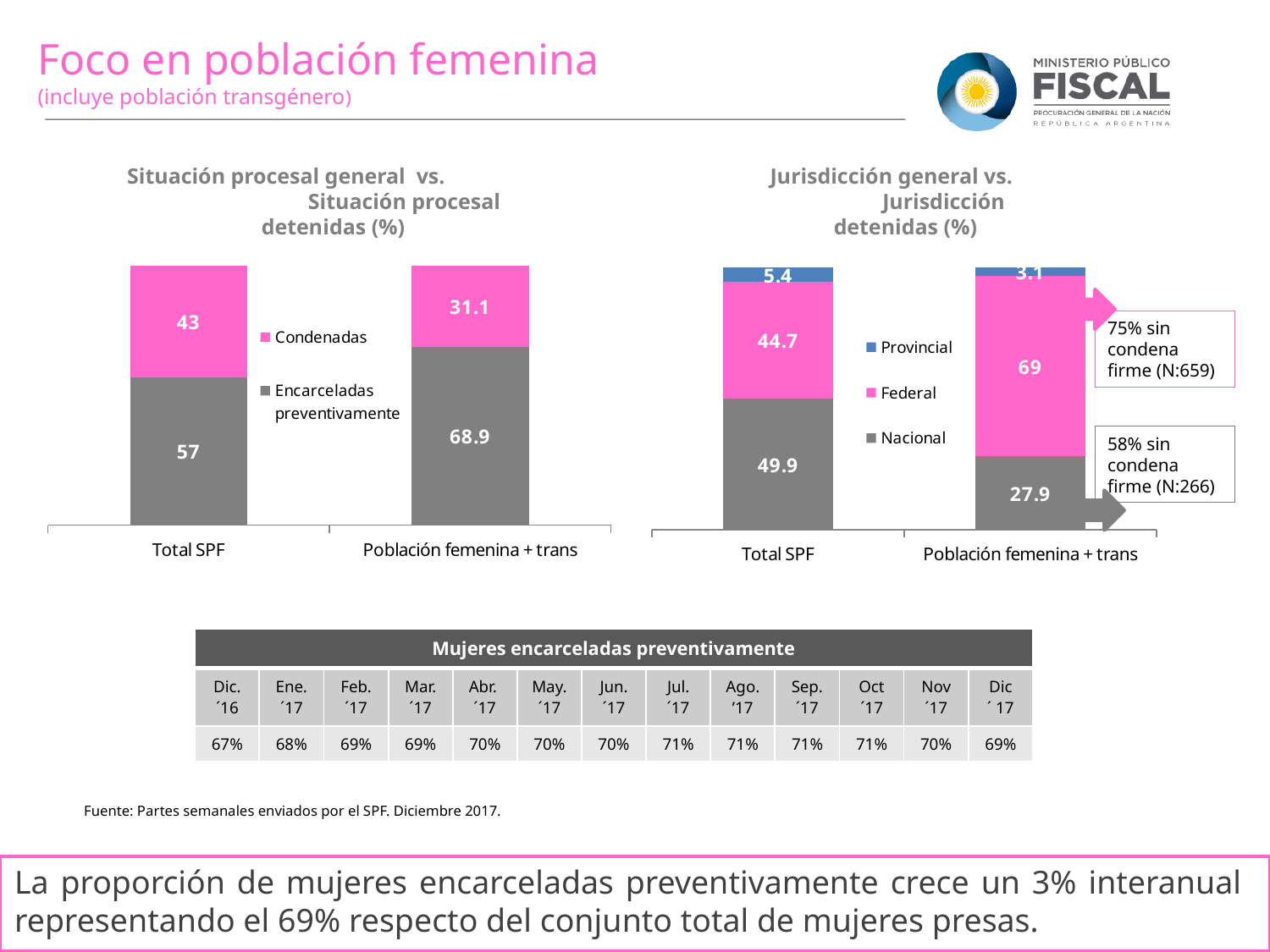
In the left chart (Situación procesal general vs. Situación procesal detenidas), what is the value for Encarceladas preventivamente for Total SPF? 57 In the left chart (Situación procesal general vs. Situación procesal detenidas), what is the value for Condenadas for Población femenina + trans? 31.1 In the right chart (Jurisdicción general vs. Jurisdicción detenidas), what is the difference between the Nacional values for Total SPF and Población femenina + trans? 22 In the right chart (Jurisdicción general vs. Jurisdicción detenidas), what is the value for Federal for Población femenina + trans? 69 In the left chart (Situación procesal general vs. Situación procesal detenidas), what is the difference between the Encarceladas preventivamente values for Población femenina + trans and Total SPF? 11.9 In the right chart (Jurisdicción general vs. Jurisdicción detenidas), how many series does the legend list? 3 What kind of chart is the right chart (Jurisdicción general vs. Jurisdicción detenidas)? Stacked bar chart In the left chart (Situación procesal general vs. Situación procesal detenidas), which category has the higher Condenadas value, Total SPF or Población femenina + trans? Total SPF In the right chart (Jurisdicción general vs. Jurisdicción detenidas), what is the value for Provincial for Total SPF? 5.4 In the left chart (Situación procesal general vs. Situación procesal detenidas), how many series does the legend list? 2 In the right chart (Jurisdicción general vs. Jurisdicción detenidas), which series has the lowest value for Población femenina + trans? Provincial In the right chart (Jurisdicción general vs. Jurisdicción detenidas), what is the value for Nacional for Total SPF? 49.9